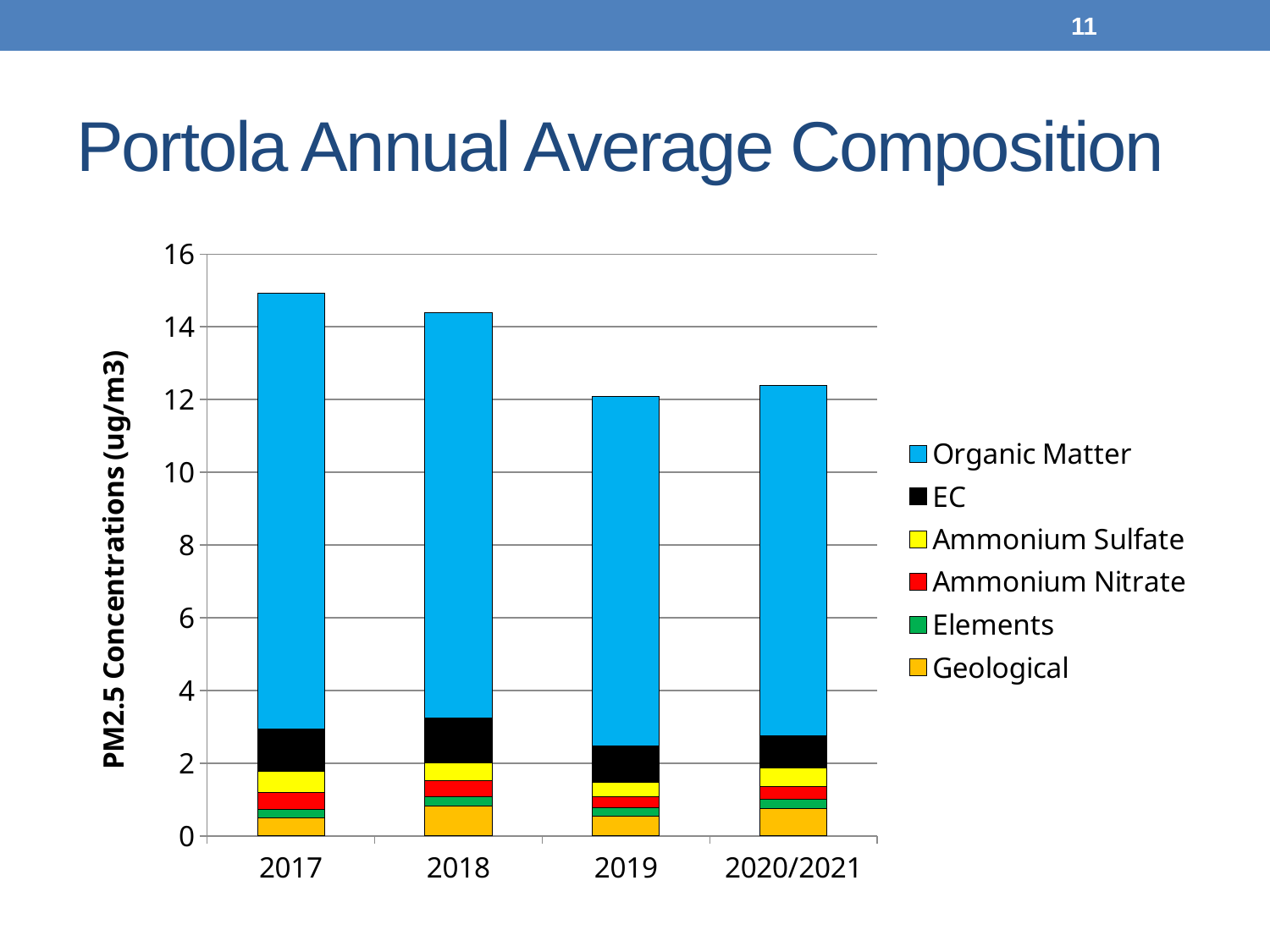
Which total bar is taller, 2017 or 2019? 2017 How many year categories are shown on the x axis? 4 Is the total bar height for 2020/2021 greater or less than 12? greater Which year has the tallest total bar? 2017 Is the total bar height for 2019 greater or less than 14? less Which series is shown at the bottom of each stacked bar? Geological Is the total bar height for 2017 greater or less than 14? greater Which total bar is taller, 2018 or 2020/2021? 2018 How many series does the legend list? 6 What is the label on the y axis? PM2.5 Concentrations (ug/m3) What kind of chart is shown on the slide? Stacked bar chart Do the total bar heights rise or fall from 2017 to 2019? fall